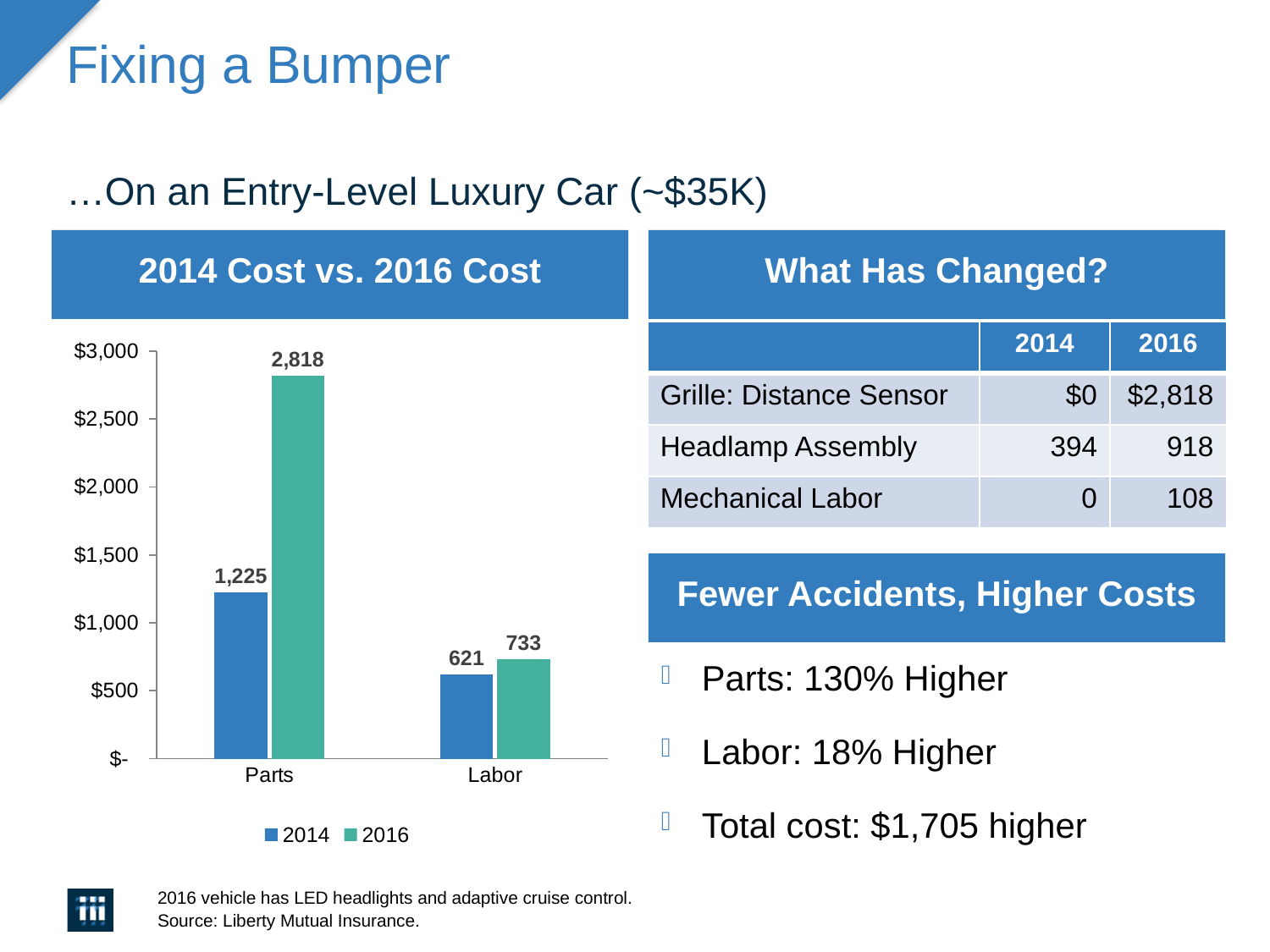
What is the 2014 value for Parts in the chart? 1,225 Which category has the highest 2016 value in the chart? Parts Which category has the lowest 2014 value in the chart? Labor How many series does the chart legend list? 2 What is the 2016 value for Parts in the chart? 2,818 What type of chart is shown on the slide? Bar chart Which is larger: the 2014 value for Parts or the 2016 value for Labor? 2014 value for Parts What is the 2016 value for Labor in the chart? 733 What is the 2014 value for Labor in the chart? 621 What is the difference between the 2016 and 2014 values for Parts? 1,593 How many categories are shown on the x axis of the chart? 2 What is the difference between the 2016 and 2014 values for Labor? 112